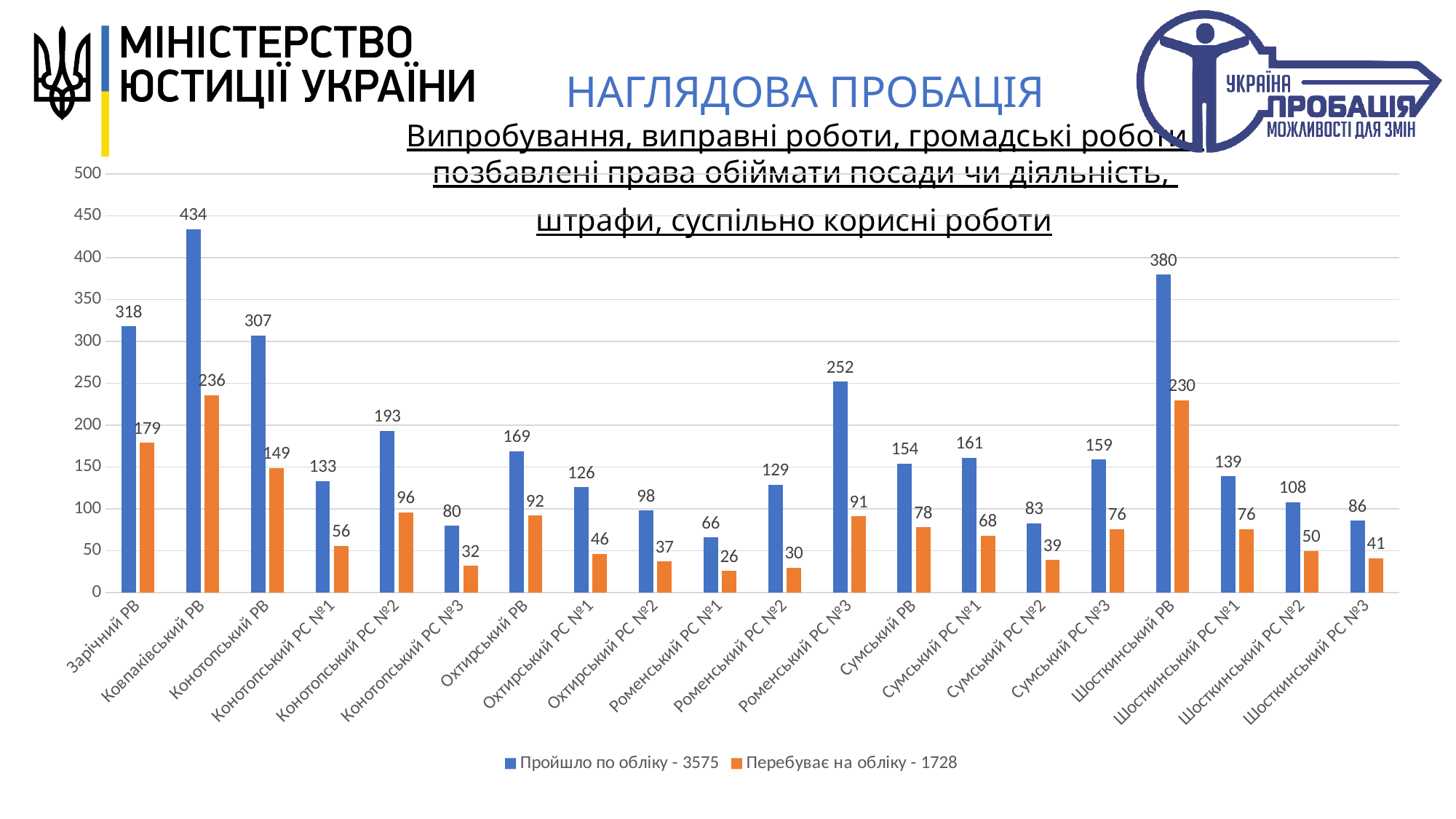
Which is larger: "Пройшло по обліку" for Сумський РС №1 or for Сумський РС №3? Сумський РС №1 How many series does the legend list? 2 What kind of chart is shown on the slide? bar chart Which category has the lowest value for "Перебуває на обліку"? Роменський РС №1 Which category has the highest value for "Пройшло по обліку"? Ковпаківський РВ What is the value of "Пройшло по обліку" for Роменський РС №3? 252 What is the value of "Пройшло по обліку" for Ковпаківський РВ? 434 What is the difference between "Пройшло по обліку" and "Перебуває на обліку" for Зарічний РВ? 139 What total is given in the legend for the series "Перебуває на обліку"? 1728 What is the value of "Перебуває на обліку" for Шосткинський РВ? 230 How many categories are shown on the x axis? 20 Is the value of "Пройшло по обліку" for Шосткинський РВ greater or less than 350? greater